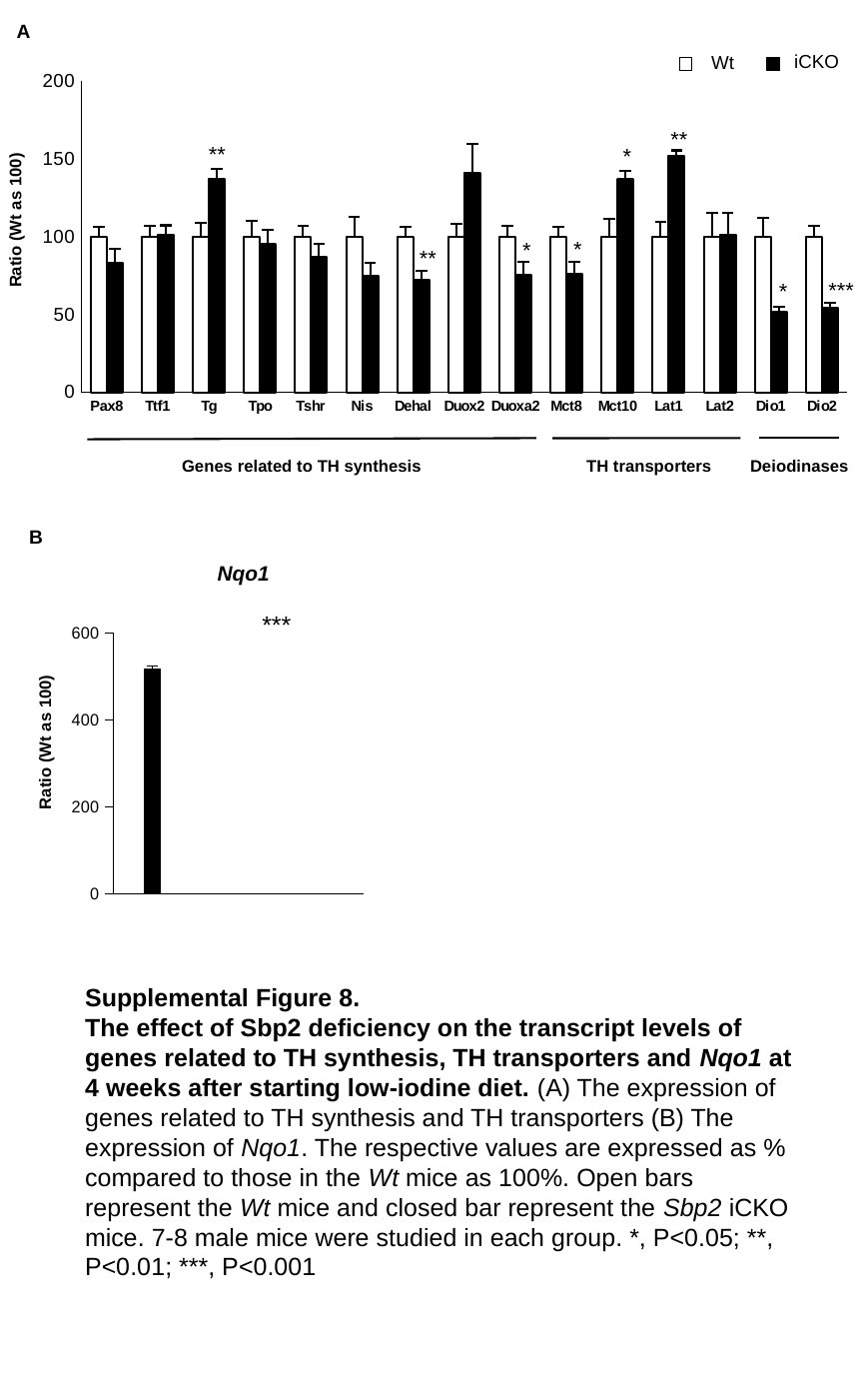
In chart A (the top chart), is the iCKO value for Tg greater or less than 100? greater In chart A (the top chart), is the iCKO value for Mct10 greater or less than 100? greater What kind of chart is chart A (the top chart)? bar chart In chart A (the top chart), what is the Wt value for Pax8? 100 In chart B (the bottom chart), is the value for Nqo1 greater or less than 400? greater In chart A (the top chart), what is the label of the y axis? Ratio (Wt as 100) In chart A (the top chart), which is larger: the iCKO value for Tg or the iCKO value for Dio2? Tg In chart A (the top chart), how many genes are shown on the x axis? 15 What is the title of chart B (the bottom chart)? Nqo1 In chart A (the top chart), which gene has the highest iCKO value? Lat1 In chart A (the top chart), how many series does the legend list? 2